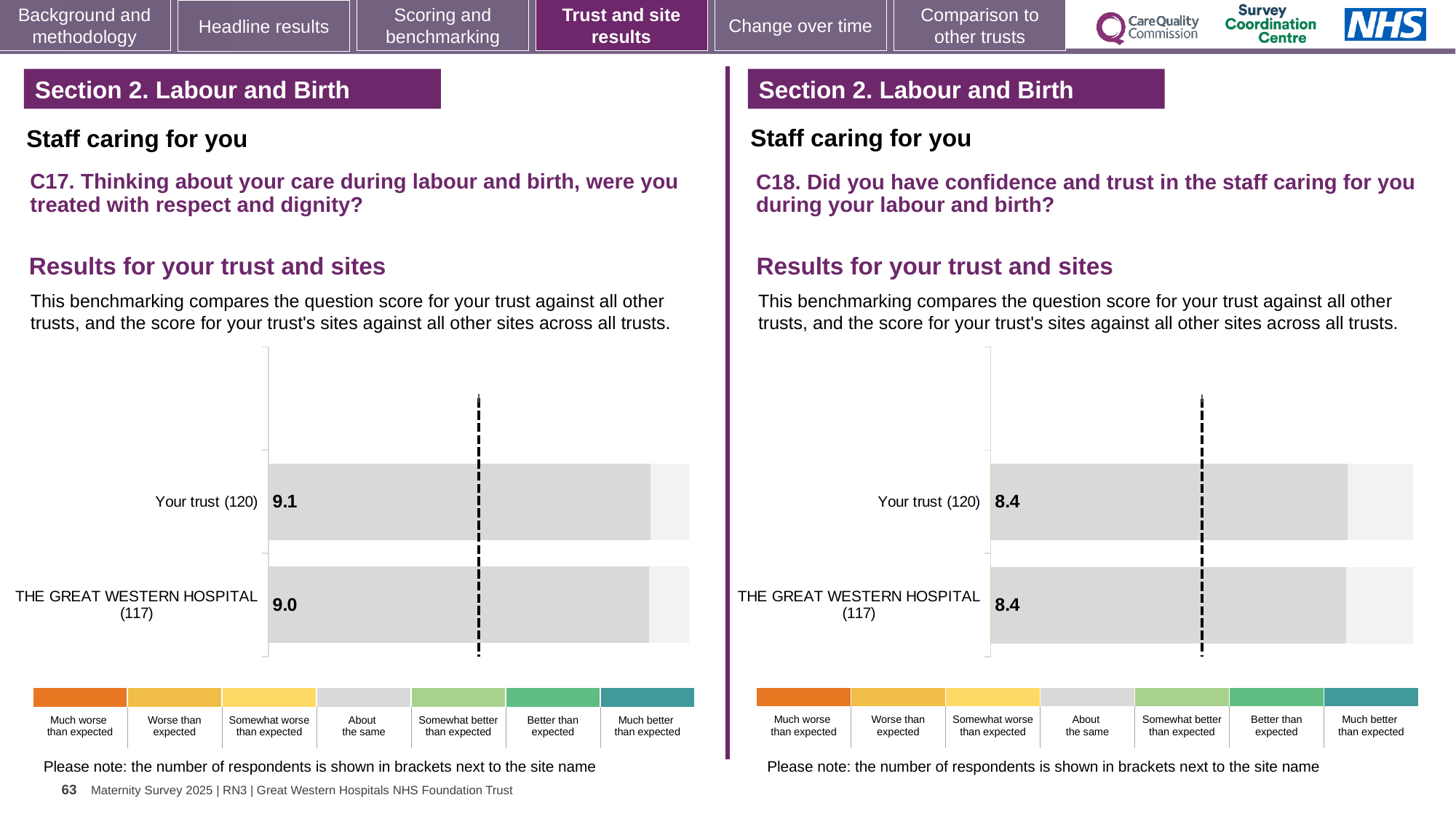
In the left chart (C17), which has the higher score: Your trust (120) or THE GREAT WESTERN HOSPITAL (117)? Your trust (120) In the right chart (C18), what is the score for THE GREAT WESTERN HOSPITAL (117)? 8.4 In the left chart (C17), what is the score for Your trust (120)? 9.1 What type of chart is used in the left chart (C17)? Bar chart How many bars are plotted in the left chart (C17)? 2 In the left chart (C17), what is the score for THE GREAT WESTERN HOSPITAL (117)? 9.0 In the right chart (C18), what is the score for Your trust (120)? 8.4 In the left chart (C17), what is the difference between the score for Your trust (120) and the score for THE GREAT WESTERN HOSPITAL (117)? 0.1 How many bars are plotted in the right chart (C18)? 2 How many respondents are shown in brackets for THE GREAT WESTERN HOSPITAL in the right chart (C18)? 117 How many benchmark categories are shown in the colour key below the left chart (C17)? 7 In the right chart (C18), what is the difference between the score for Your trust (120) and the score for THE GREAT WESTERN HOSPITAL (117)? 0.0